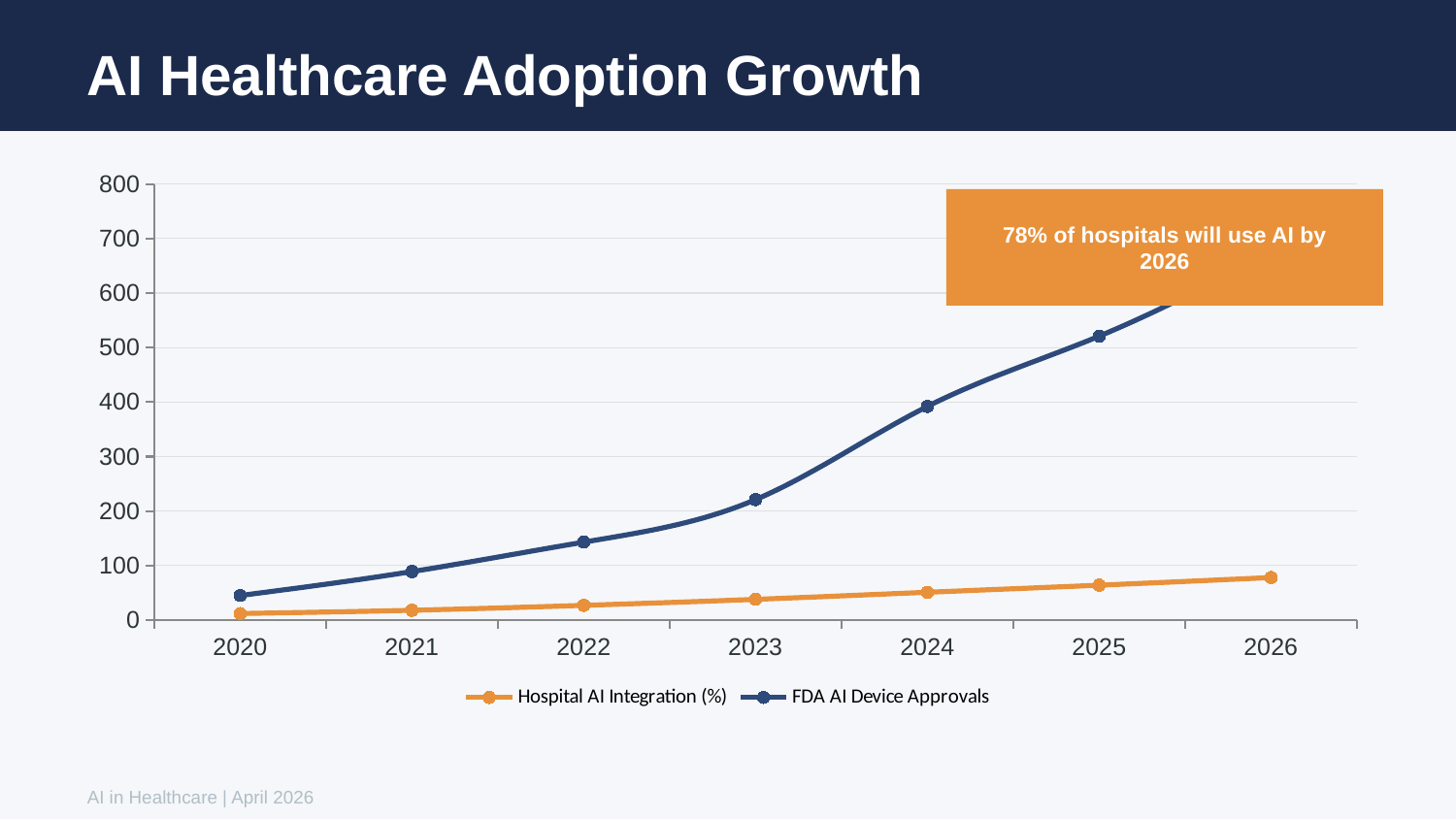
What kind of chart is shown on the slide? line chart Does the FDA AI Device Approvals series rise or fall from 2020 to 2025? rise In which year is the FDA AI Device Approvals value lowest? 2020 How many years are shown on the x axis? 7 Which series has the larger value in 2025, Hospital AI Integration (%) or FDA AI Device Approvals? FDA AI Device Approvals How many series does the legend list? 2 What does the orange callout box on the chart say? 78% of hospitals will use AI by 2026 Does the Hospital AI Integration (%) series rise or fall from 2020 to 2026? rise In which year is the Hospital AI Integration (%) value lowest? 2020 Is the Hospital AI Integration (%) value for 2026 greater or less than 100? less Is the FDA AI Device Approvals value for 2022 greater or less than 200? less Is the FDA AI Device Approvals value for 2024 greater or less than 300? greater